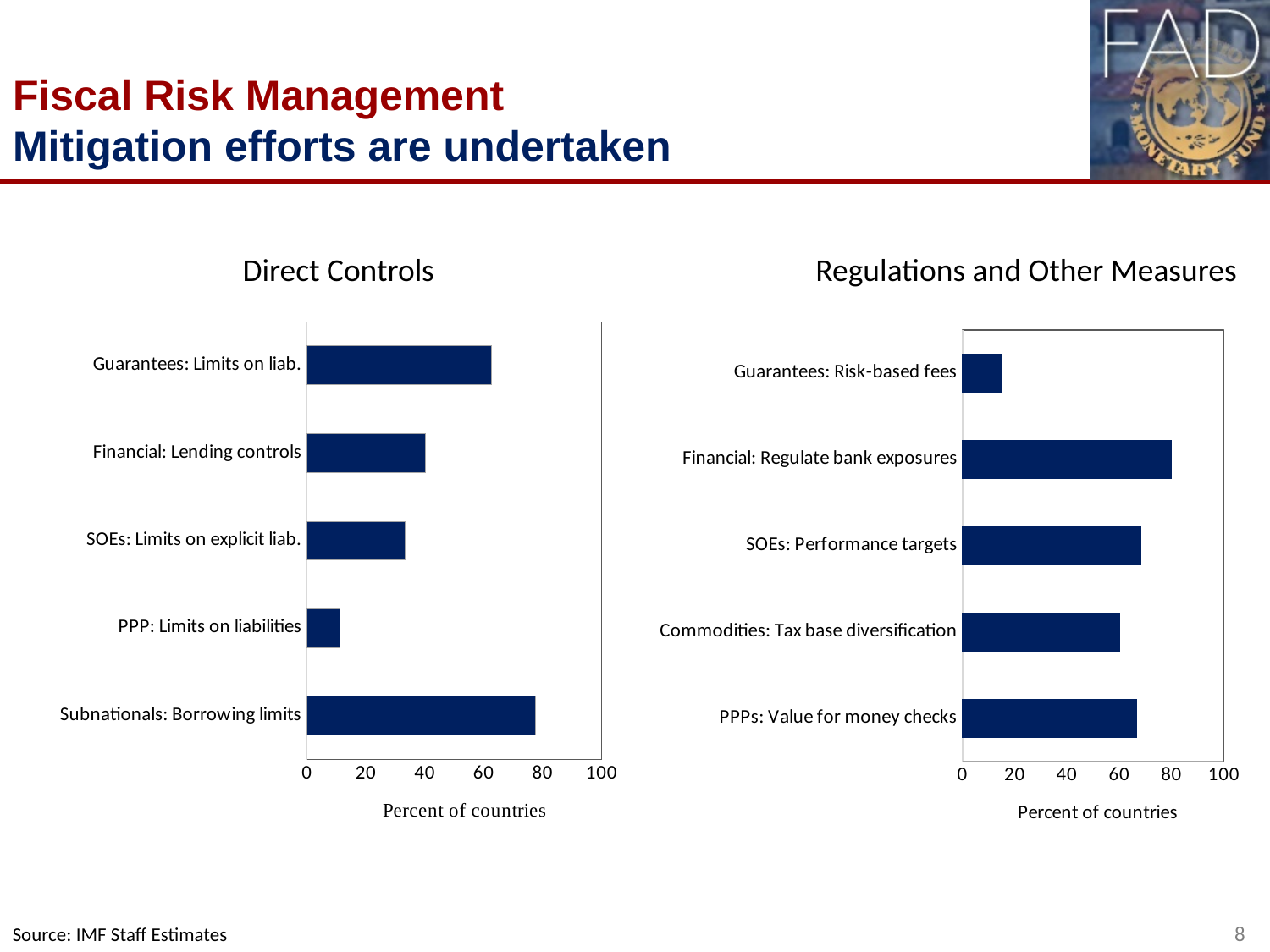
In the "Direct Controls" chart, is the value for "PPP: Limits on liabilities" greater or less than 20? less What is the x-axis label of the "Regulations and Other Measures" chart? Percent of countries In the "Direct Controls" chart, which is larger: "Financial: Lending controls" or "SOEs: Limits on explicit liab."? Financial: Lending controls In the "Direct Controls" chart, which category has the lowest value? PPP: Limits on liabilities In the "Direct Controls" chart, is the value for "Guarantees: Limits on liab." greater or less than 60? greater What kind of chart is the "Direct Controls" chart? bar chart In the "Regulations and Other Measures" chart, which category has the lowest value? Guarantees: Risk-based fees How many categories are shown in the "Regulations and Other Measures" chart? 5 How many categories are shown in the "Direct Controls" chart? 5 In the "Direct Controls" chart, which category has the highest value? Subnationals: Borrowing limits In the "Regulations and Other Measures" chart, which category has the highest value? Financial: Regulate bank exposures In the "Regulations and Other Measures" chart, is the value for "Guarantees: Risk-based fees" greater or less than 20? less